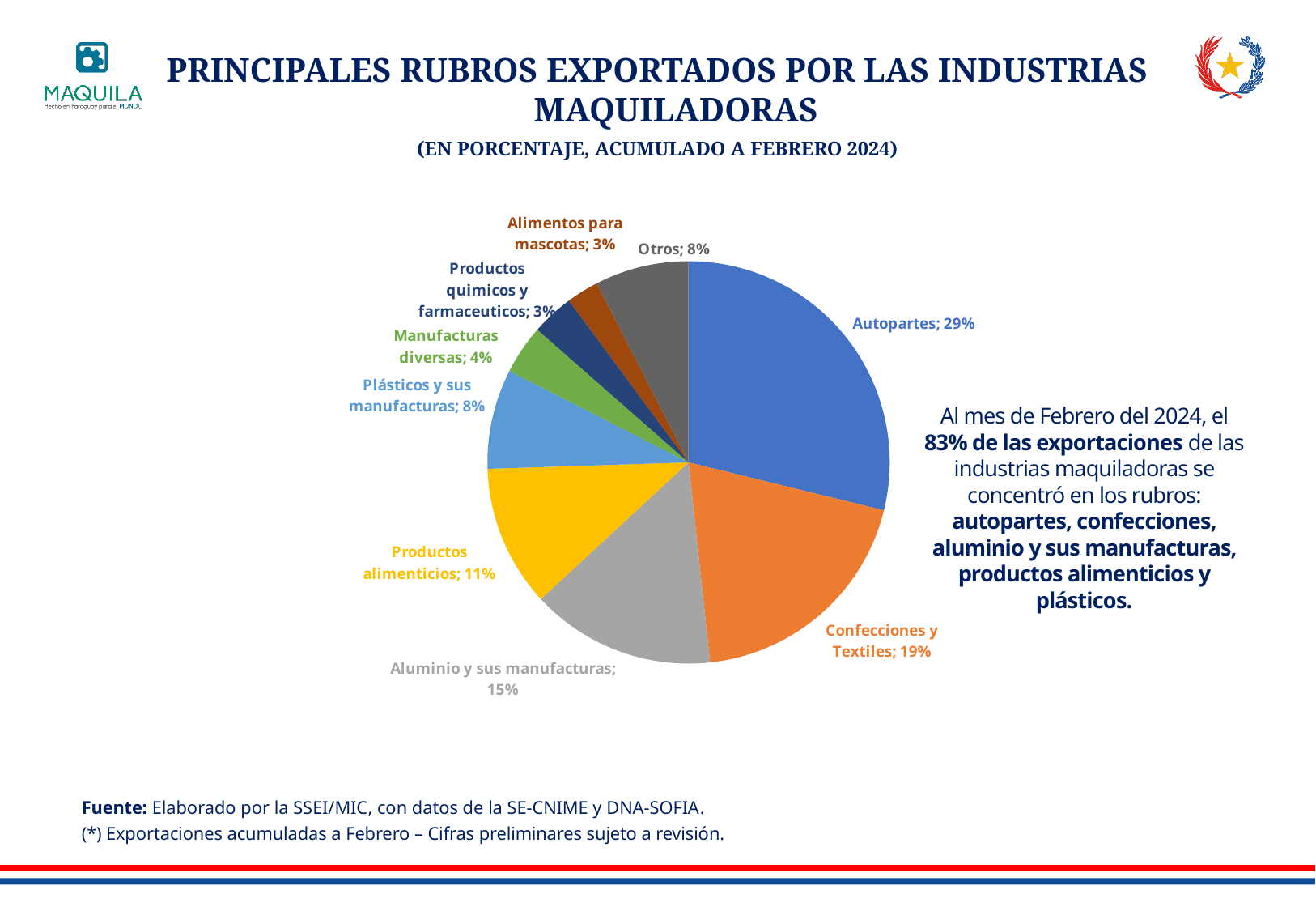
What percentage is shown for Confecciones y Textiles? 19% Which category has the largest slice of the pie chart? Autopartes What is the difference in percentage points between Autopartes and Confecciones y Textiles? 10 How many categories are shown in the pie chart? 9 What share of exports does Autopartes account for in the pie chart? 29% What is the combined share of Alimentos para mascotas and Productos quimicos y farmaceuticos? 6% What percentage is shown for Manufacturas diversas? 4% What is the subtitle shown below the main title of the chart? (EN PORCENTAJE, ACUMULADO A FEBRERO 2024) What type of chart is shown on the slide? Pie chart What percentage is shown for Aluminio y sus manufacturas? 15% Which is larger, Plásticos y sus manufacturas or Productos alimenticios? Productos alimenticios What percentage is shown for Productos alimenticios? 11%